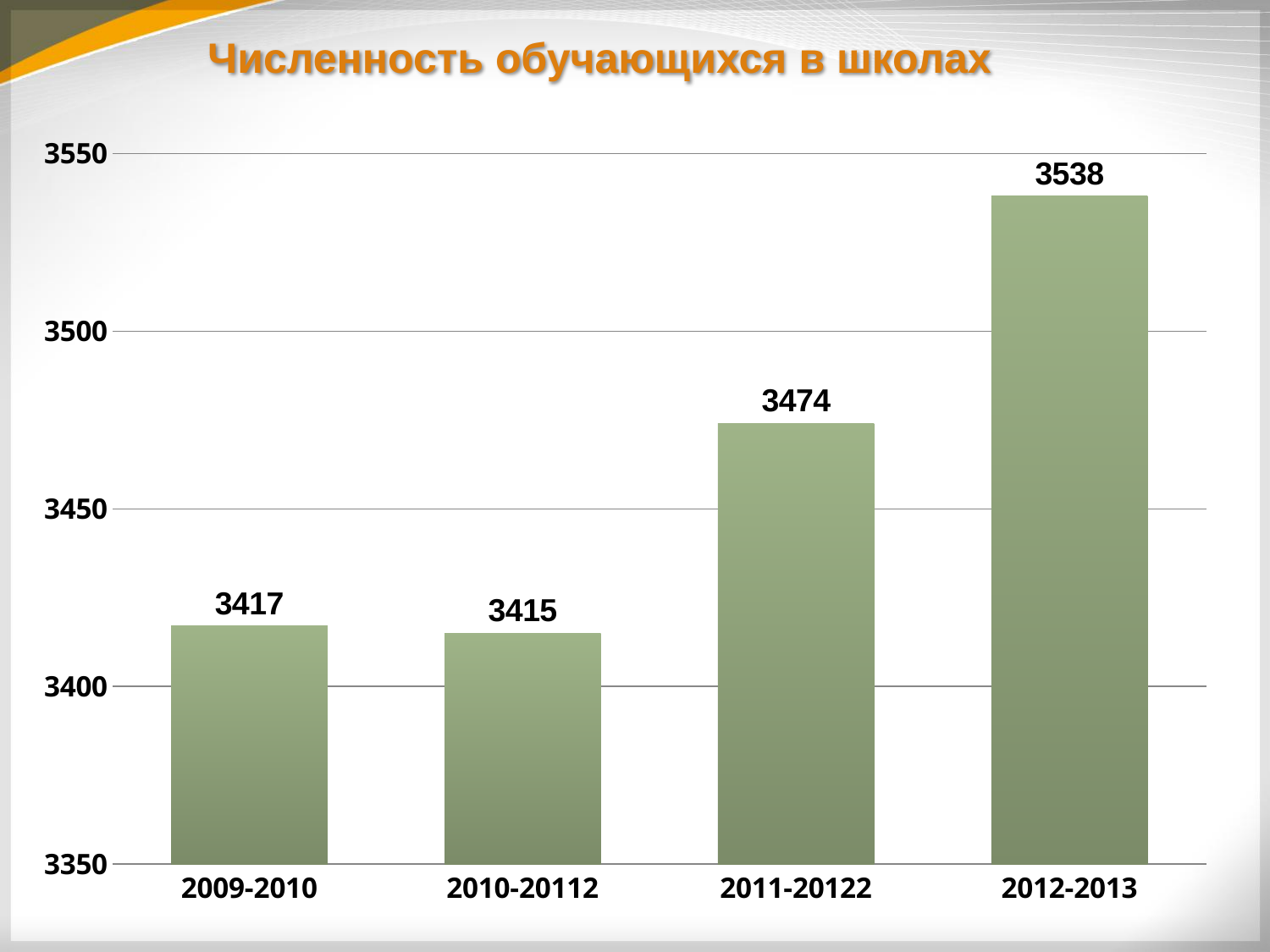
Is the value for 2012-2013 greater or less than 3500? greater Which is larger, the value for 2011-20122 or the value for 2009-2010? 2011-20122 What is the difference between the values for 2012-2013 and 2011-20122? 64 Which category has the highest value? 2012-2013 What is the value for 2011-20122? 3474 What is the difference between the values for 2009-2010 and 2010-20112? 2 Which category has the lowest value? 2010-20112 What is the title of the chart? Численность обучающихся в школах What is the value for 2009-2010? 3417 What kind of chart is shown on the slide? bar chart What is the value for 2012-2013? 3538 How many categories are shown on the x axis? 4